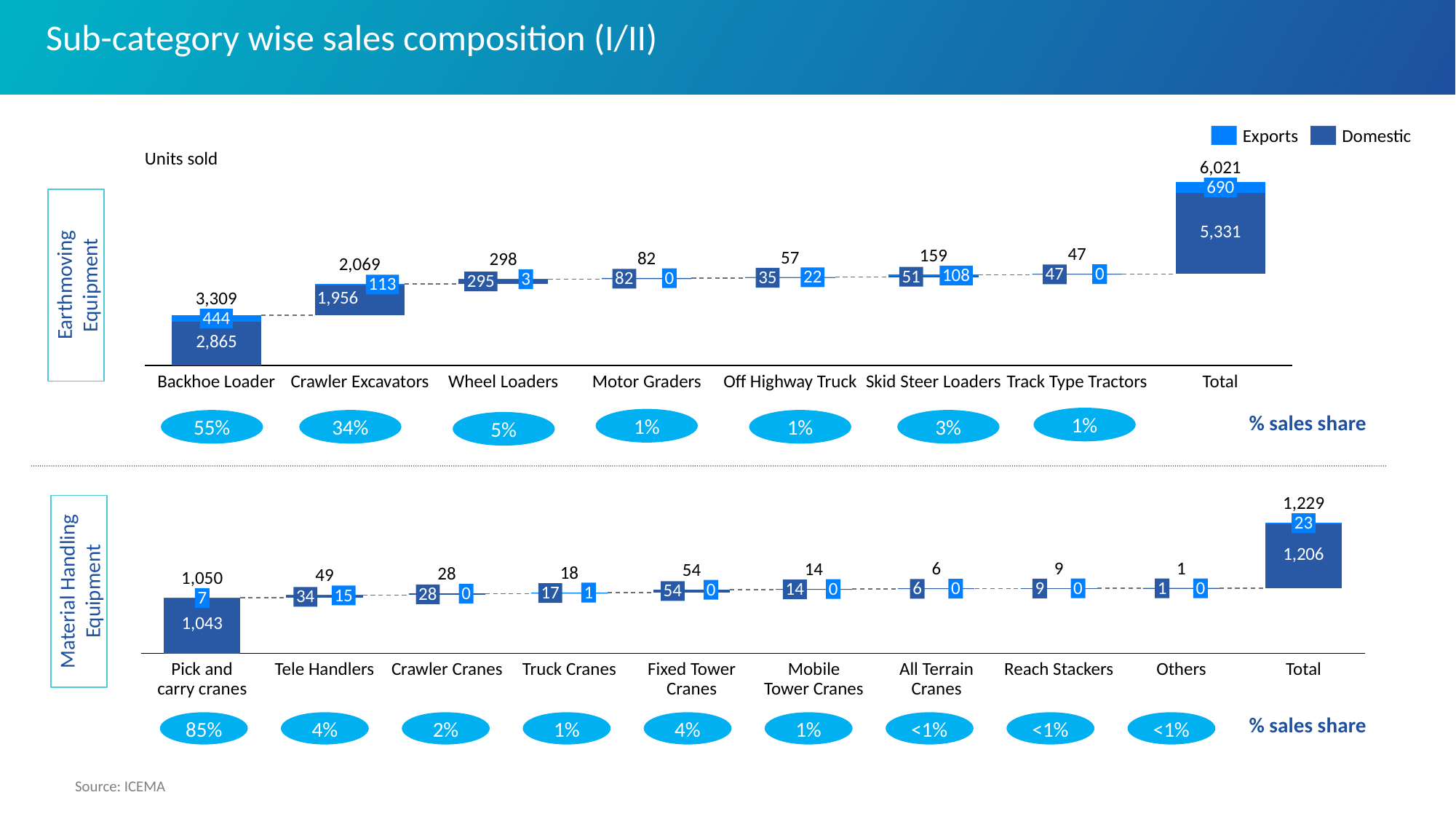
In the Earthmoving Equipment chart, what is the Exports value for Skid Steer Loaders? 108 In the Earthmoving Equipment chart, which sub-category has the lowest total units sold? Track Type Tractors In the Earthmoving Equipment chart, what is the difference between the total units for Backhoe Loader and Crawler Excavators? 1,240 In the Earthmoving Equipment chart, what is the % sales share for Wheel Loaders? 5% How many series does the legend list? 2 In the Material Handling Equipment chart, what is the total units sold for Fixed Tower Cranes? 54 In the Earthmoving Equipment chart, how many units of Backhoe Loaders were sold in total? 3,309 In the Earthmoving Equipment chart, which sub-category has the highest total units sold (excluding Total)? Backhoe Loader In the Earthmoving Equipment chart, what is the Domestic value for Crawler Excavators? 1,956 In the Material Handling Equipment chart, how many sub-categories are shown excluding Total? 9 In the Material Handling Equipment chart, which is larger: the total for Tele Handlers or the total for Crawler Cranes? Tele Handlers In the Material Handling Equipment chart, what is the Domestic value for Pick and carry cranes? 1,043